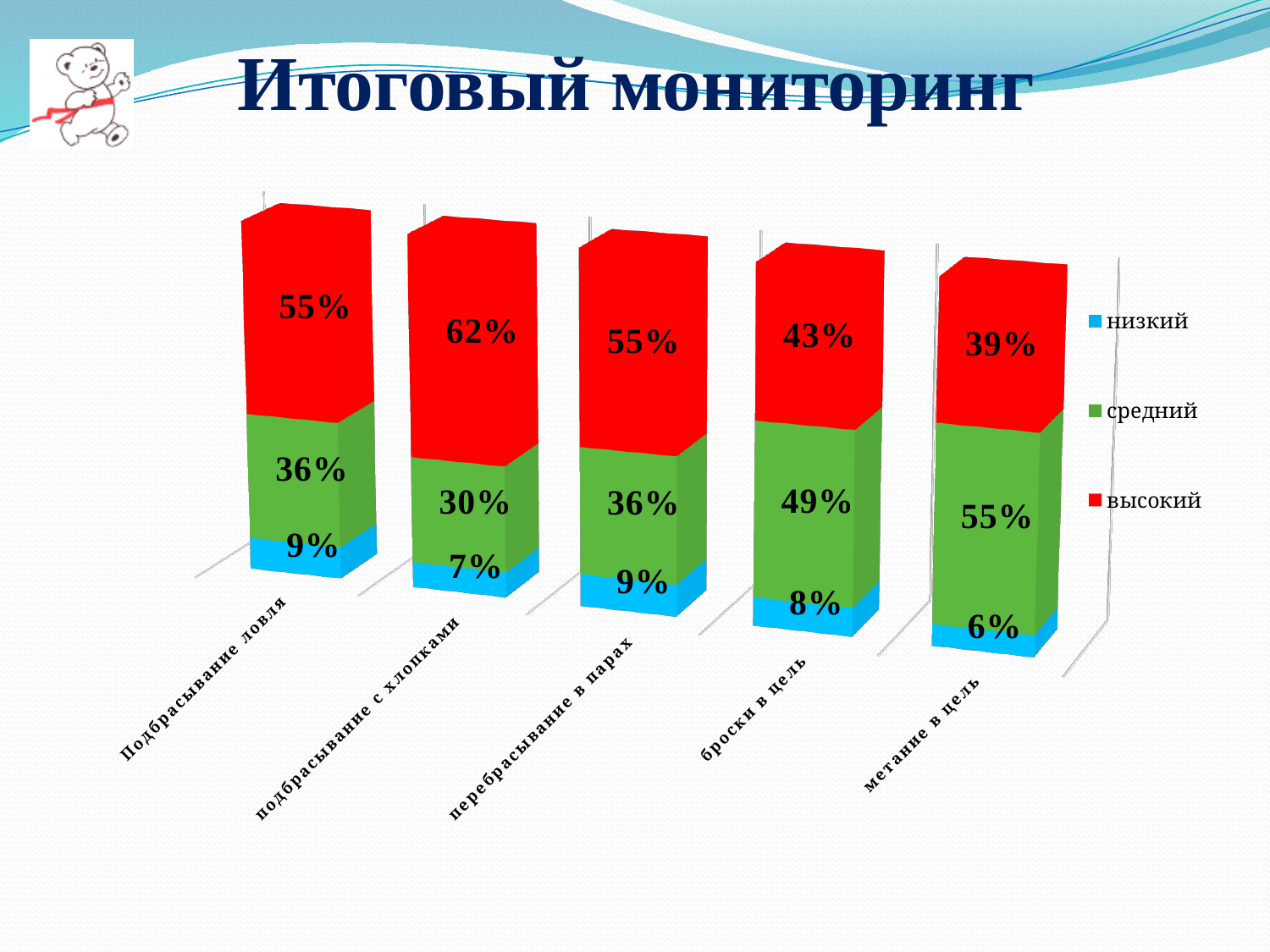
For броски в цель, which is larger: the средний value or the высокий value? средний Which category has the lowest value for the низкий series? метание в цель What is the difference between the высокий values for подбрасывание с хлопками and метание в цель? 23% Which category has the highest value for the высокий series? подбрасывание с хлопками What is the total of the stacked bar for метание в цель? 100% How many categories are shown on the x axis? 5 What is the value of the высокий series for подбрасывание с хлопками? 62% How many series does the legend list? 3 What is the value of the средний series for броски в цель? 49% What kind of chart is shown on the slide? stacked bar chart What is the title of the chart on the slide? Итоговый мониторинг What is the value of the низкий series for метание в цель? 6%